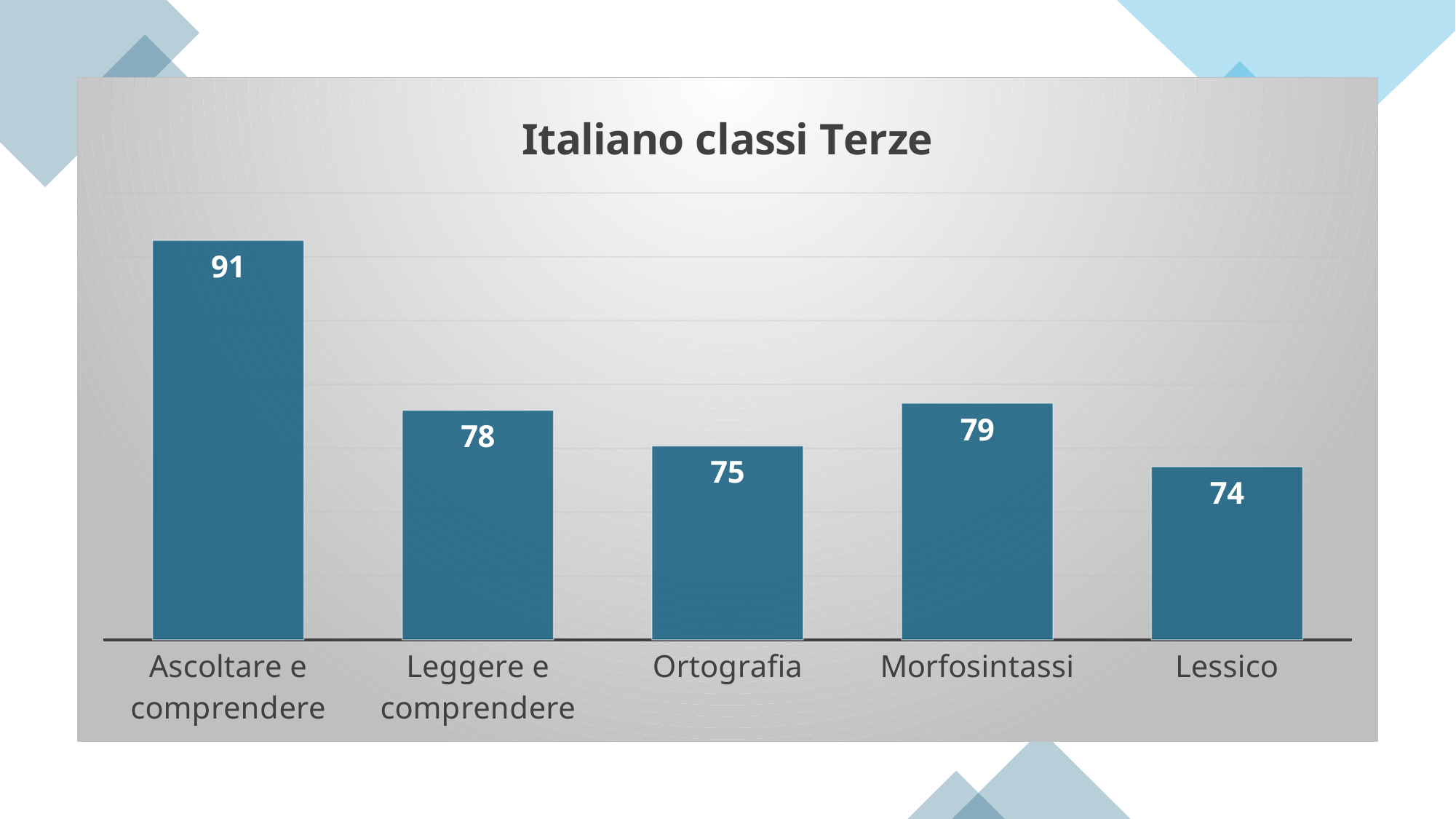
What is the value for Ascoltare e comprendere? 91 Which category has the lowest value? Lessico What is the value for Leggere e comprendere? 78 Which is larger, the value for Leggere e comprendere or the value for Morfosintassi? Morfosintassi What is the title of the chart? Italiano classi Terze How many categories are shown in the chart? 5 What is the value for Ortografia? 75 What is the difference between the values for Morfosintassi and Ortografia? 4 What is the value for Morfosintassi? 79 What is the value for Lessico? 74 Which category has the highest value? Ascoltare e comprendere What is the difference between the values for Ascoltare e comprendere and Lessico? 17